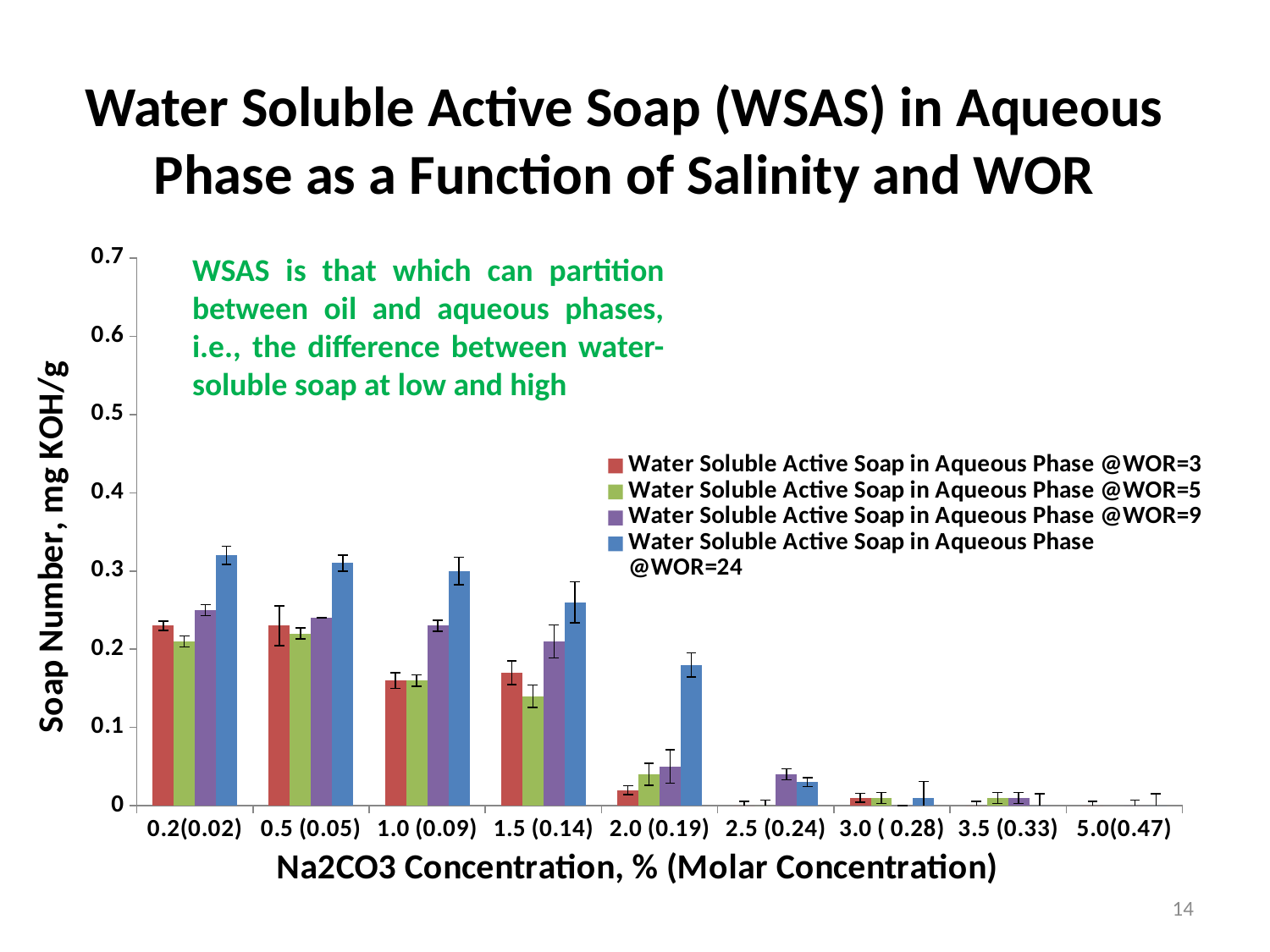
How many Na2CO3 concentration categories are shown on the x axis? 9 What colour represents Water Soluble Active Soap in Aqueous Phase @WOR=24 in the legend? blue At 0.2(0.02) Na2CO3 concentration, which series has the highest soap number? Water Soluble Active Soap in Aqueous Phase @WOR=24 Is the value for Water Soluble Active Soap in Aqueous Phase @WOR=5 at 1.5 (0.14) greater or less than 0.2? less Is the value for Water Soluble Active Soap in Aqueous Phase @WOR=24 at 2.0 (0.19) greater or less than 0.1? greater Overall, do the soap number values rise or fall as Na2CO3 concentration increases along the x axis? fall Is the value for Water Soluble Active Soap in Aqueous Phase @WOR=24 at 0.2(0.02) greater or less than 0.2? greater How many series does the legend list? 4 At 1.0 (0.09) Na2CO3 concentration, which is larger: the value for @WOR=24 or the value for @WOR=3? @WOR=24 What is the title of the y axis? Soap Number, mg KOH/g What kind of chart is shown on the slide? bar chart